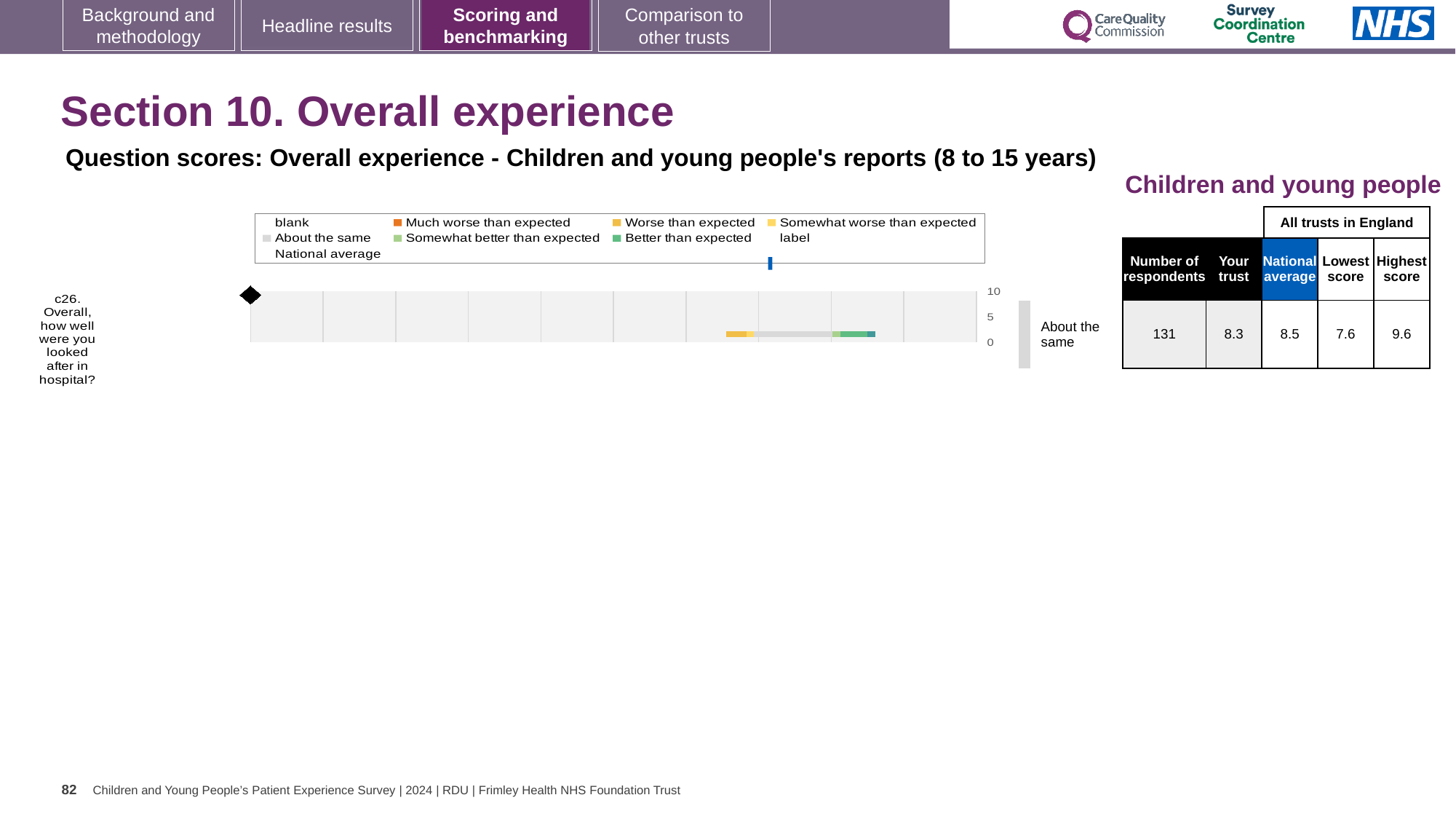
Which benchmark category is the trust's score for question c26 placed in? About the same Which is larger for question c26: the 'Your trust' score or the national average? National average What is the difference between the national average and the 'Your trust' score for question c26? 0.2 What is the maximum value shown on the chart's score axis? 10 What type of chart is used to show the c26 question score? bar chart What is the national average score for question c26? 8.5 What is the highest score among all trusts in England for question c26? 9.6 How many survey questions are plotted on the chart? 1 What is the difference between the highest score and the lowest score for question c26? 2.0 How many respondents answered question c26? 131 What is the 'Your trust' score for question c26 'Overall, how well were you looked after in hospital?' 8.3 What is the lowest score among all trusts in England for question c26? 7.6